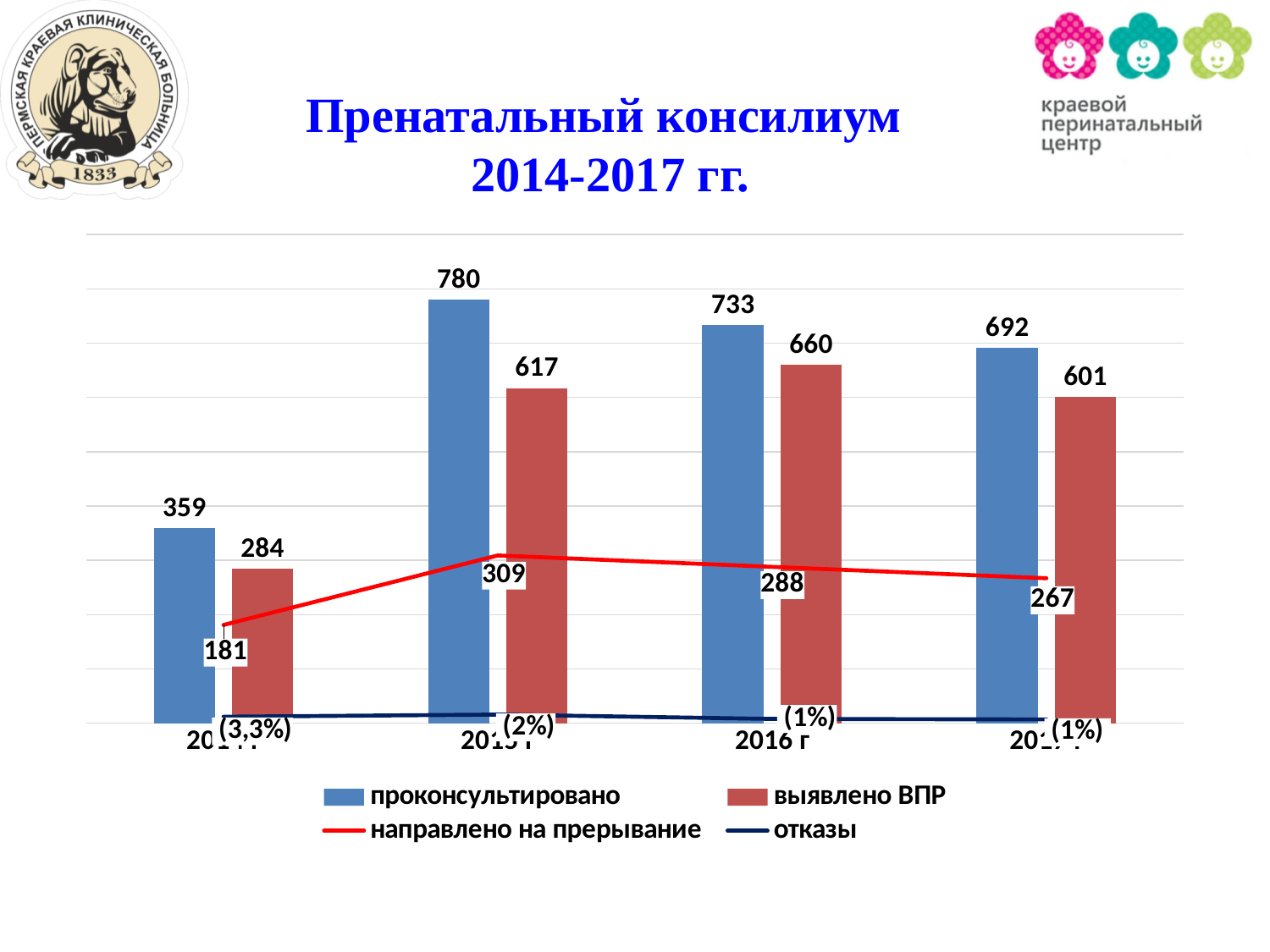
In which year is проконсультировано highest? 2015 Which is larger in 2016: проконсультировано or выявлено ВПР? проконсультировано What is the title of the chart? Пренатальный консилиум 2014-2017 гг. What is the difference between проконсультировано and выявлено ВПР in 2017? 91 What is the value of проконсультировано for 2015? 780 How many years are shown on the x axis? 4 How many series does the legend list? 4 What is the value of направлено на прерывание for 2014? 181 What is the value of выявлено ВПР for 2016? 660 In which year is выявлено ВПР lowest? 2014 What is the value of отказы for 2014? (3,3%) Does направлено на прерывание rise or fall from 2015 to 2017? fall